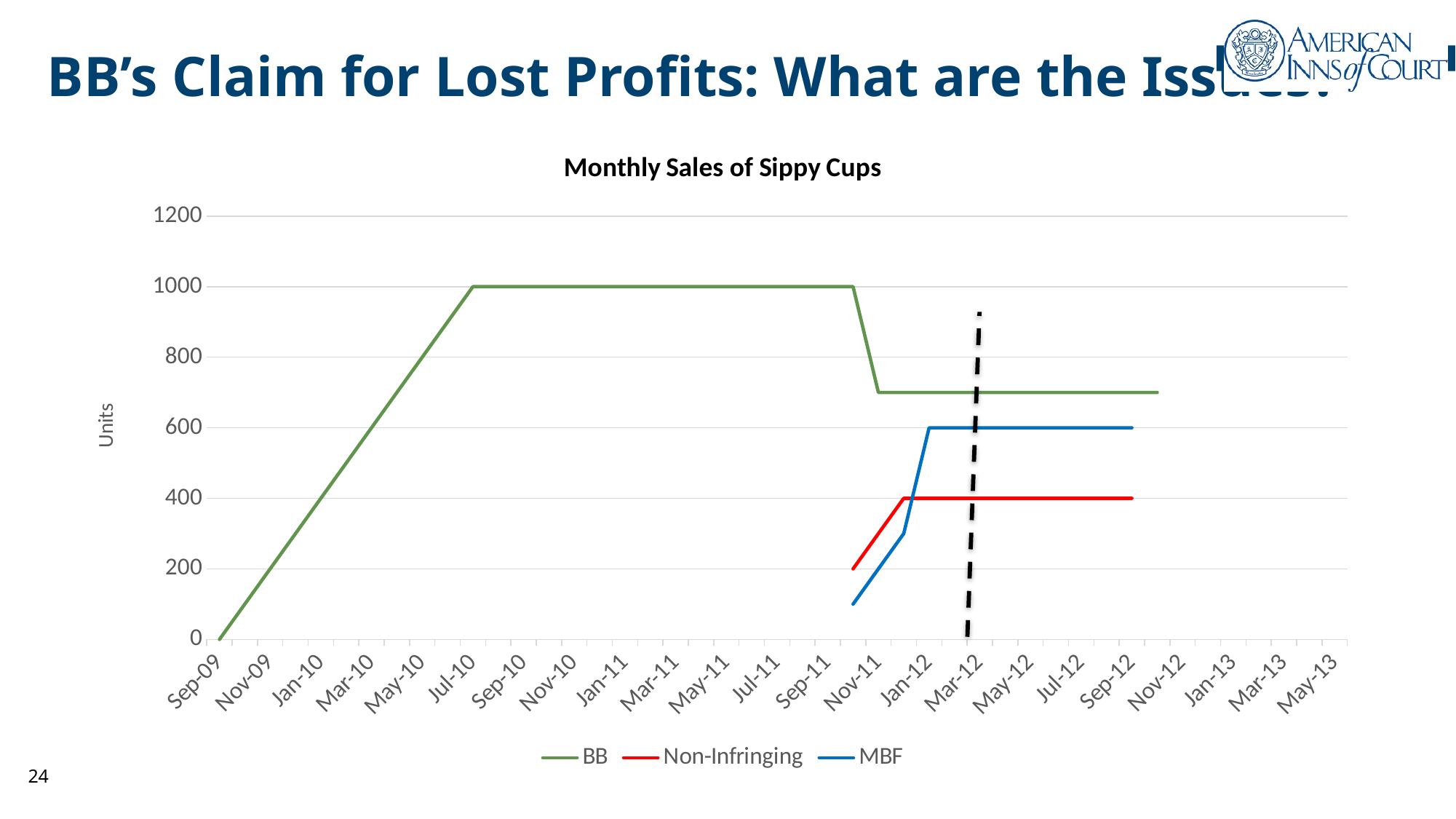
What is the value for BB in Jul-10? 1000 How many series does the legend list? 3 Is the value for BB in Jul-12 greater or less than 600? greater What is the value for MBF in Jul-12? 600 What is the difference between MBF and Non-Infringing in Jul-12? 200 What is the value for Non-Infringing in Jul-12? 400 What is the title of the chart? Monthly Sales of Sippy Cups In Jul-12, which is larger, MBF or Non-Infringing? MBF What kind of chart is shown on the slide? line chart What is the label on the vertical axis? Units Which series has the highest value in Jul-12? BB What is the value for BB in Sep-09? 0